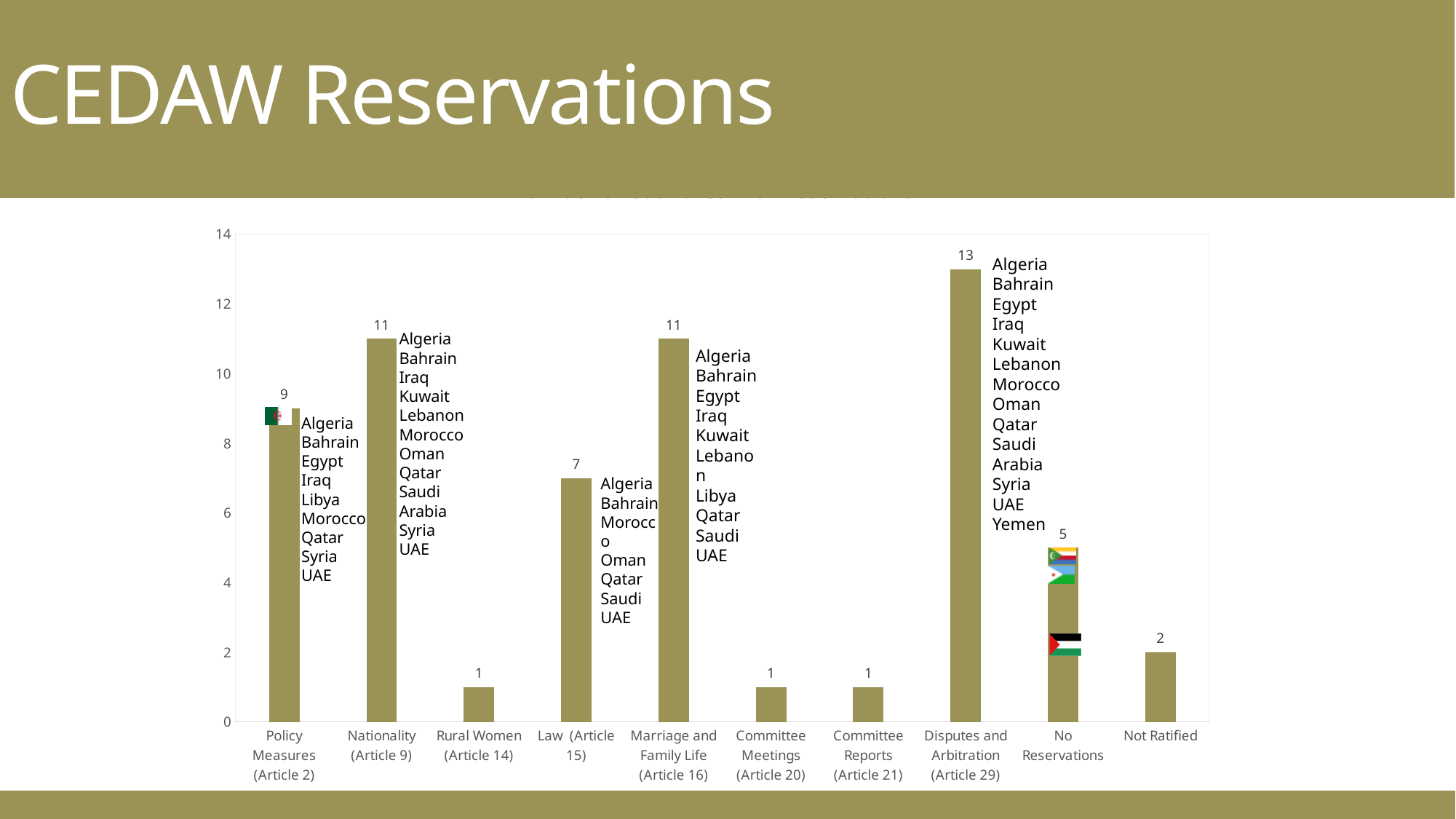
What is the value for Law (Article 15)? 7 What is the difference between the values for Disputes and Arbitration (Article 29) and Nationality (Article 9)? 2 What is the value for Disputes and Arbitration (Article 29)? 13 What is the title of the slide? CEDAW Reservations What is the value for Policy Measures (Article 2)? 9 How many categories have a value of 1? 3 Which is larger, the value for Policy Measures (Article 2) or the value for Law (Article 15)? Policy Measures (Article 2) What is the value for Not Ratified? 2 How many categories are shown on the x axis? 10 Which category has the highest value? Disputes and Arbitration (Article 29) What kind of chart is shown on the slide? Bar chart What is the value for No Reservations? 5